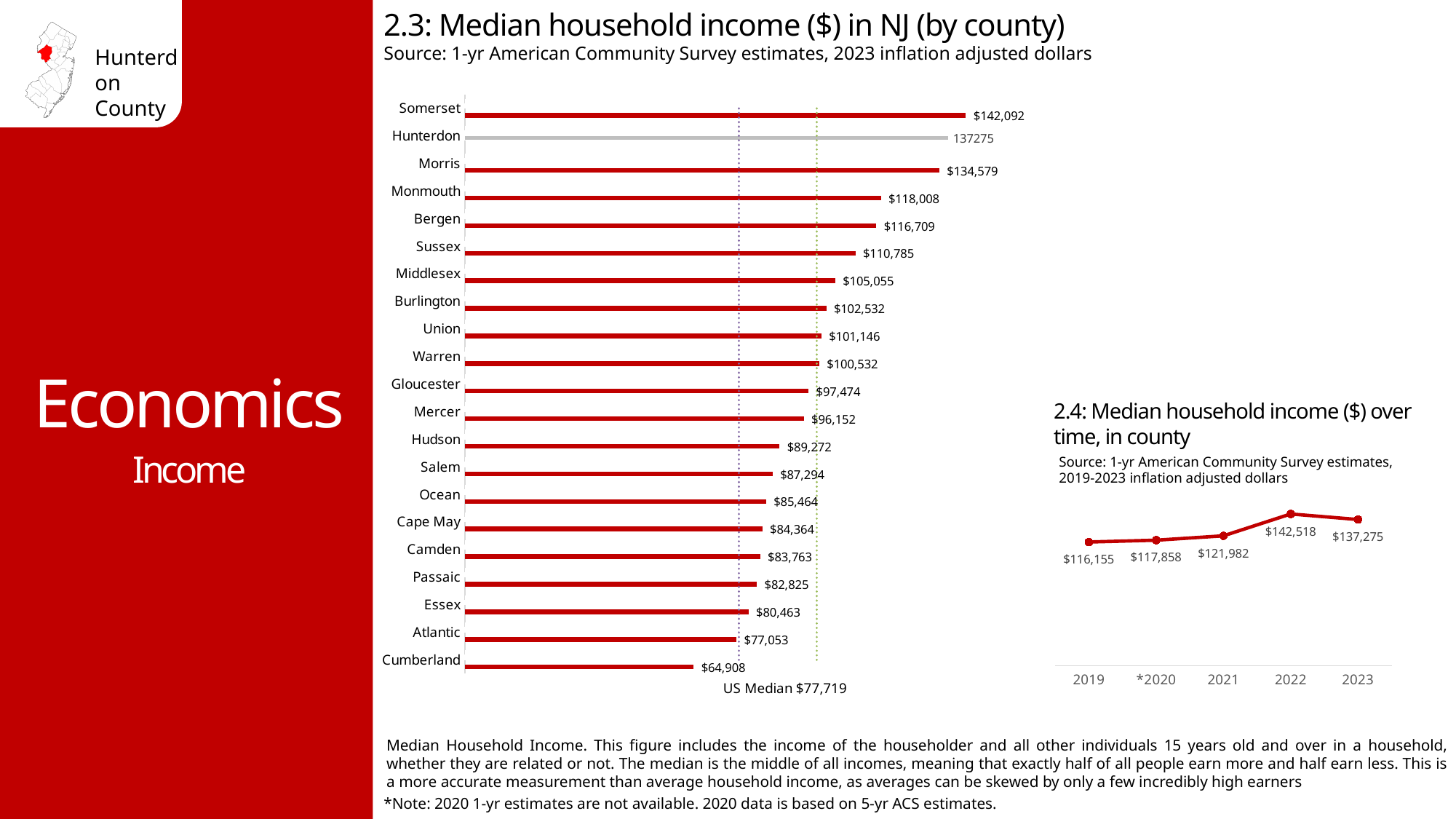
In chart 2.3 (Median household income in NJ by county), what is the median household income for Cumberland? $64,908 In chart 2.4 (Median household income over time, in county), how many years are plotted? 5 In chart 2.4 (Median household income over time, in county), what is the value for 2022? $142,518 What type of chart is chart 2.3 (Median household income in NJ by county)? Bar chart In chart 2.3 (Median household income in NJ by county), which has a higher median household income, Bergen or Sussex? Bergen In chart 2.3 (Median household income in NJ by county), what is the median household income for Somerset? $142,092 In chart 2.4 (Median household income over time, in county), which year has the lowest median household income? 2019 In chart 2.3 (Median household income in NJ by county), what is the difference between Somerset's and Cumberland's median household income? $77,184 In chart 2.3 (Median household income in NJ by county), which county has the highest median household income? Somerset In chart 2.3 (Median household income in NJ by county), how many counties are shown? 21 In chart 2.4 (Median household income over time, in county), what is the difference between the 2022 and 2023 values? $5,243 In chart 2.3 (Median household income in NJ by county), which county has the lowest median household income? Cumberland